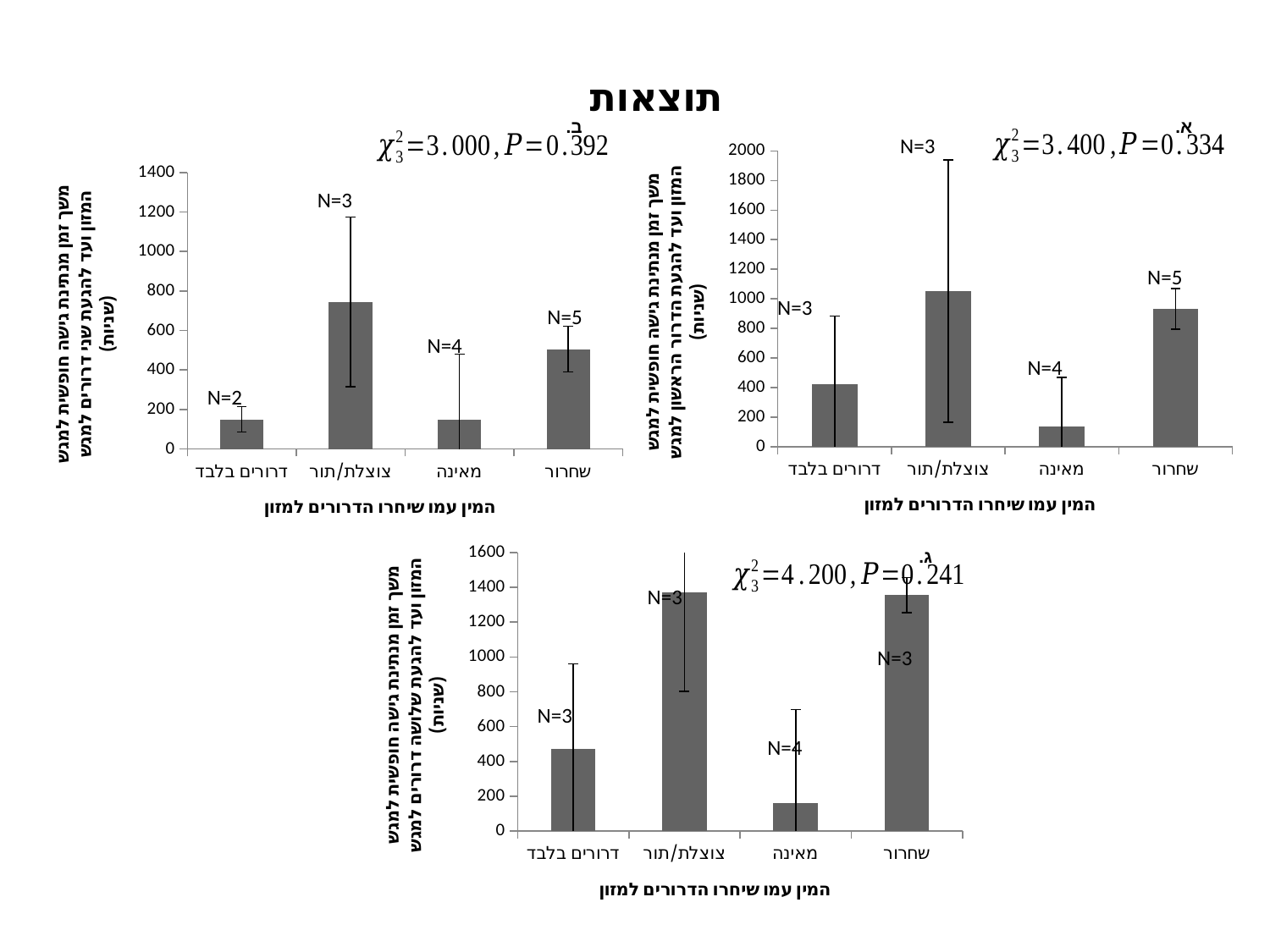
How many categories are shown on the x axis of the bottom chart? 4 In the top-left chart, is the value for צוצלת/תור greater or less than 600? greater In the top-right chart, which category has the lowest bar? מאינה In the top-right chart, which is larger, the value for דרורים בלבד or the value for שחרור? שחרור In the top-right chart, is the value for שחרור greater or less than 800? greater What type of chart is the top-left chart on the slide? bar chart In the top-left chart, is the value for מאינה greater or less than 400? less In the top-left chart, what N label is printed above the דרורים בלבד bar? N=2 In the bottom chart, which category has the lowest bar? מאינה In the top-right chart, what N label is printed above the שחרור bar? N=5 In the top-left chart, which category has the highest bar? צוצלת/תור